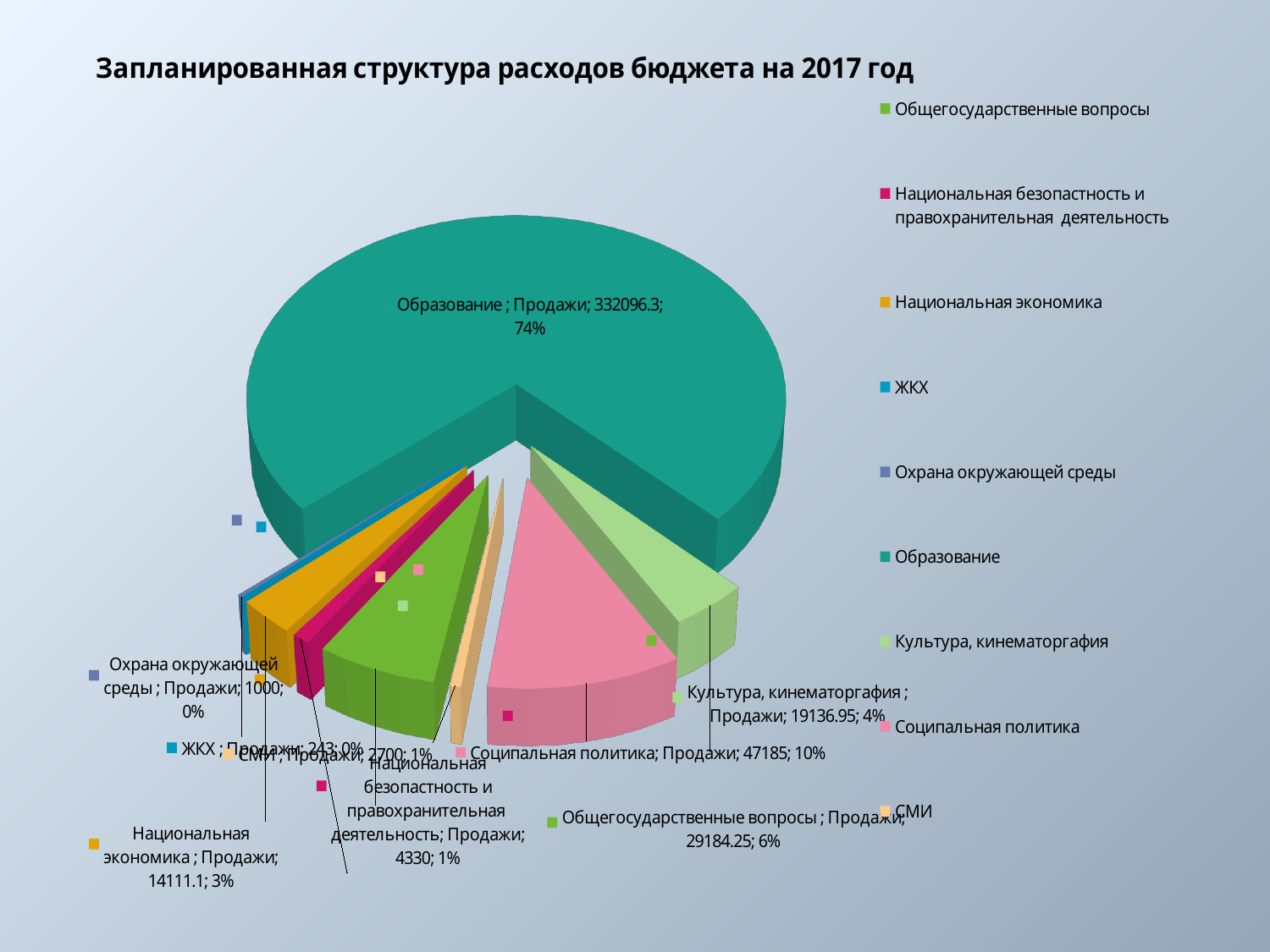
What share of the pie does Общегосударственные вопросы take? 6% What is the value for Социальная политика? 47185 Which is larger, Социальная политика or Национальная экономика? Социальная политика What is the value for Культура, кинематоргафия? 19136.95 What share of the pie does Образование take? 74% What is the value for Образование? 332096.3 Which category has the largest slice? Образование What is the value for Национальная безопастность и правохранительная деятельность? 4330 What is the title of the chart? Запланированная структура расходов бюджета на 2017 год What is the difference between the values for Социальная политика and Общегосударственные вопросы? 18000.75 How many categories does the legend list? 9 What kind of chart is shown on the slide? Pie chart